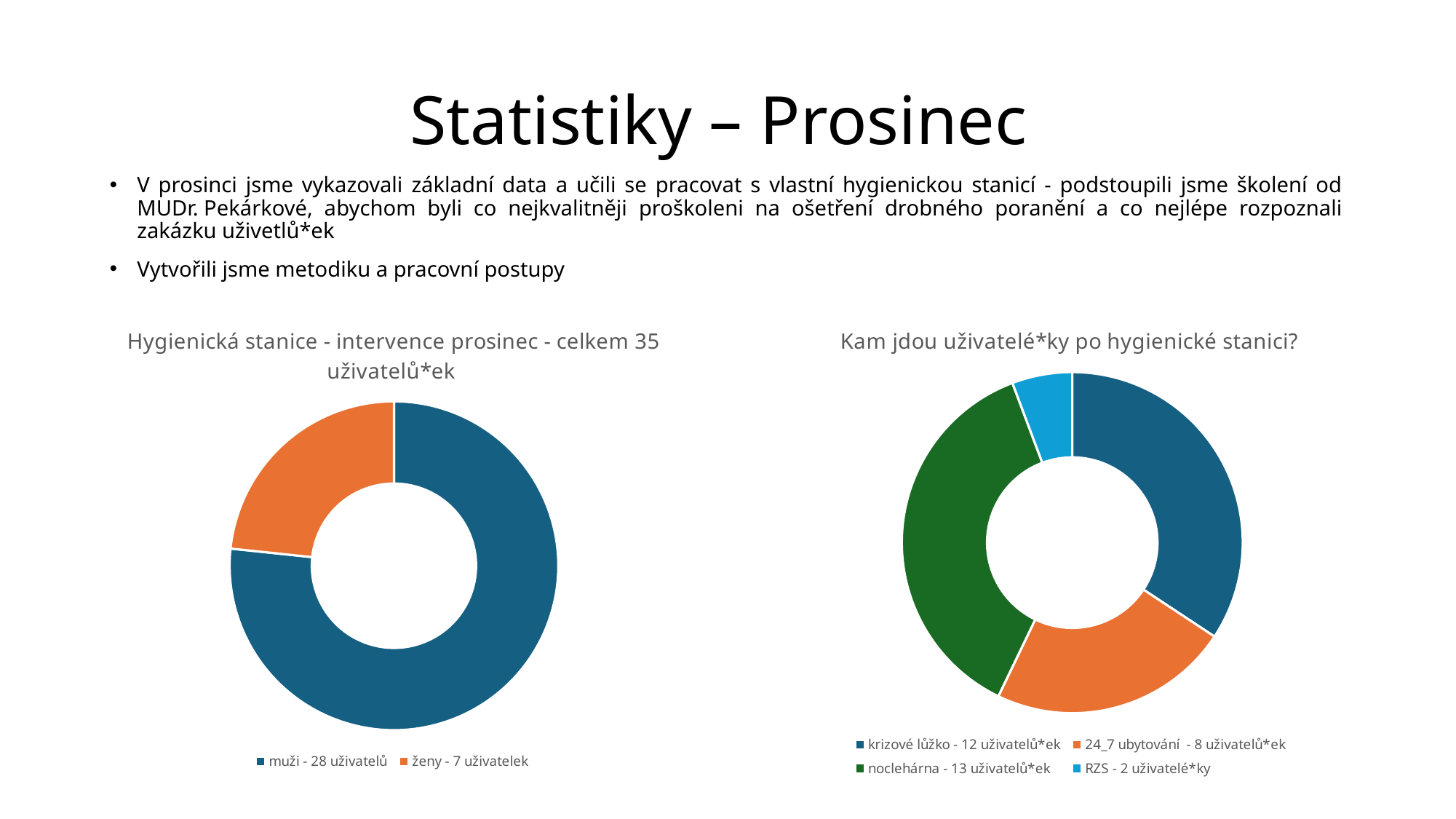
In the left chart (Hygienická stanice - intervence prosinec), what is the total number of users stated in the title? 35 In the left chart (Hygienická stanice - intervence prosinec), how many users are listed for "muži"? 28 In the right chart (Kam jdou uživatelé*ky po hygienické stanici?), what is the difference between krizové lůžko and 24_7 ubytování? 4 In the right chart (Kam jdou uživatelé*ky po hygienické stanici?), how many users go to "noclehárna"? 13 What kind of chart is the left chart (Hygienická stanice - intervence prosinec)? doughnut chart In the right chart (Kam jdou uživatelé*ky po hygienické stanici?), which category has the lowest number of users? RZS In the right chart (Kam jdou uživatelé*ky po hygienické stanici?), how many users go to "RZS"? 2 In the right chart (Kam jdou uživatelé*ky po hygienické stanici?), which category has the highest number of users? noclehárna In the left chart (Hygienická stanice - intervence prosinec), what share of the total do muži represent? 80% In the left chart (Hygienická stanice - intervence prosinec), what is the difference between the number of muži and ženy? 21 How many categories does the legend of the right chart (Kam jdou uživatelé*ky po hygienické stanici?) list? 4 In the left chart (Hygienická stanice - intervence prosinec), how many users are listed for "ženy"? 7